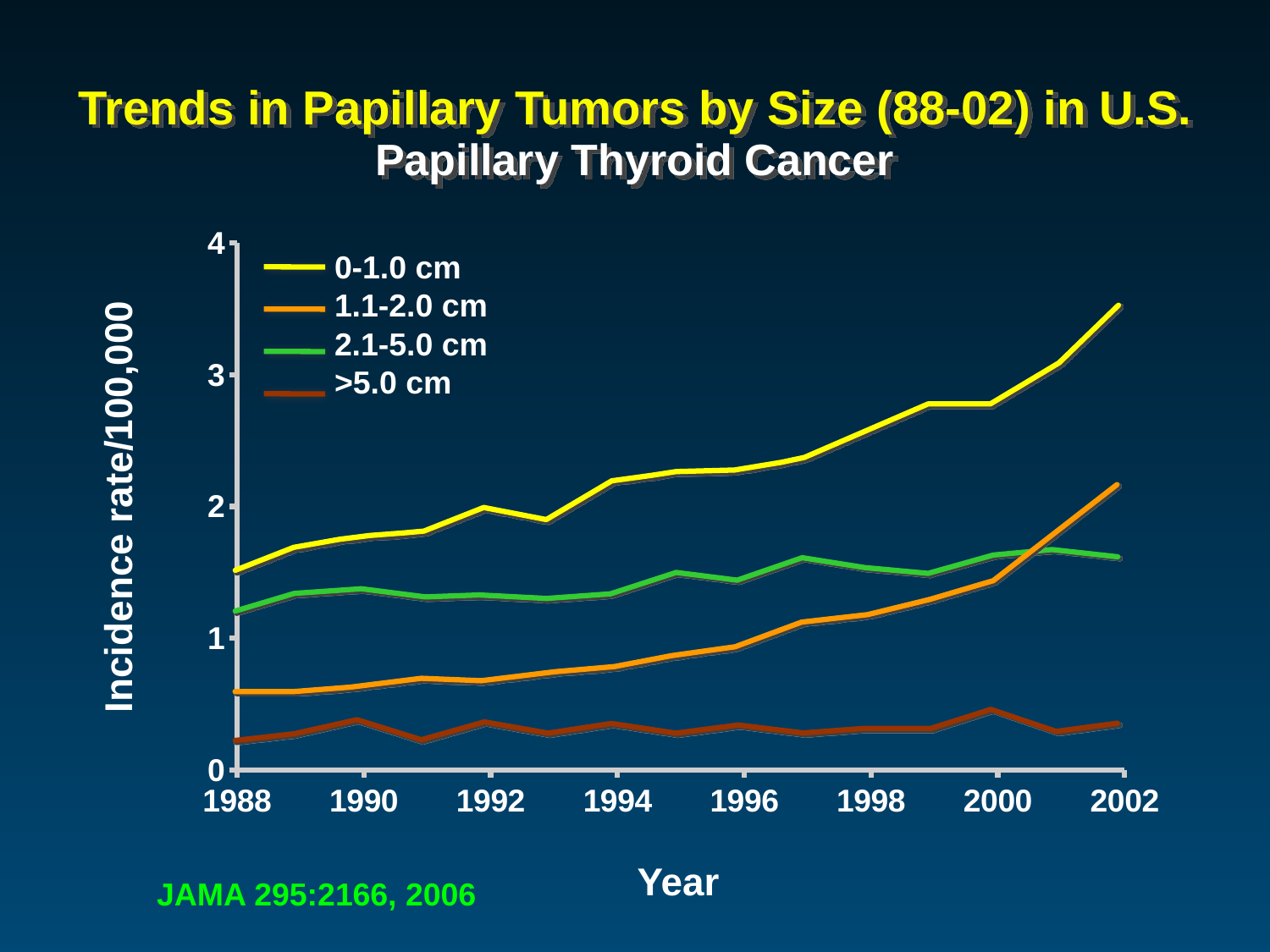
What is the label of the y axis? Incidence rate/100,000 Does the incidence rate for 0-1.0 cm tumors rise or fall from 1988 to 2002? Rise Is the incidence rate for >5.0 cm tumors in 2002 greater or less than 1? less In 1988, which has the higher incidence rate: 1.1-2.0 cm or 2.1-5.0 cm tumors? 2.1-5.0 cm Is the incidence rate for 0-1.0 cm tumors in 1988 greater or less than 2? less In 2002, which has the higher incidence rate: 1.1-2.0 cm or 2.1-5.0 cm tumors? 1.1-2.0 cm Is the incidence rate for 0-1.0 cm tumors in 2002 greater or less than 3? greater Which tumor size group has the lowest incidence rate across the whole period? >5.0 cm Which tumor size group has the highest incidence rate in 2002? 0-1.0 cm How many series does the legend list? 4 How many year labels are shown on the x axis? 8 What kind of chart is shown on the slide? Line chart